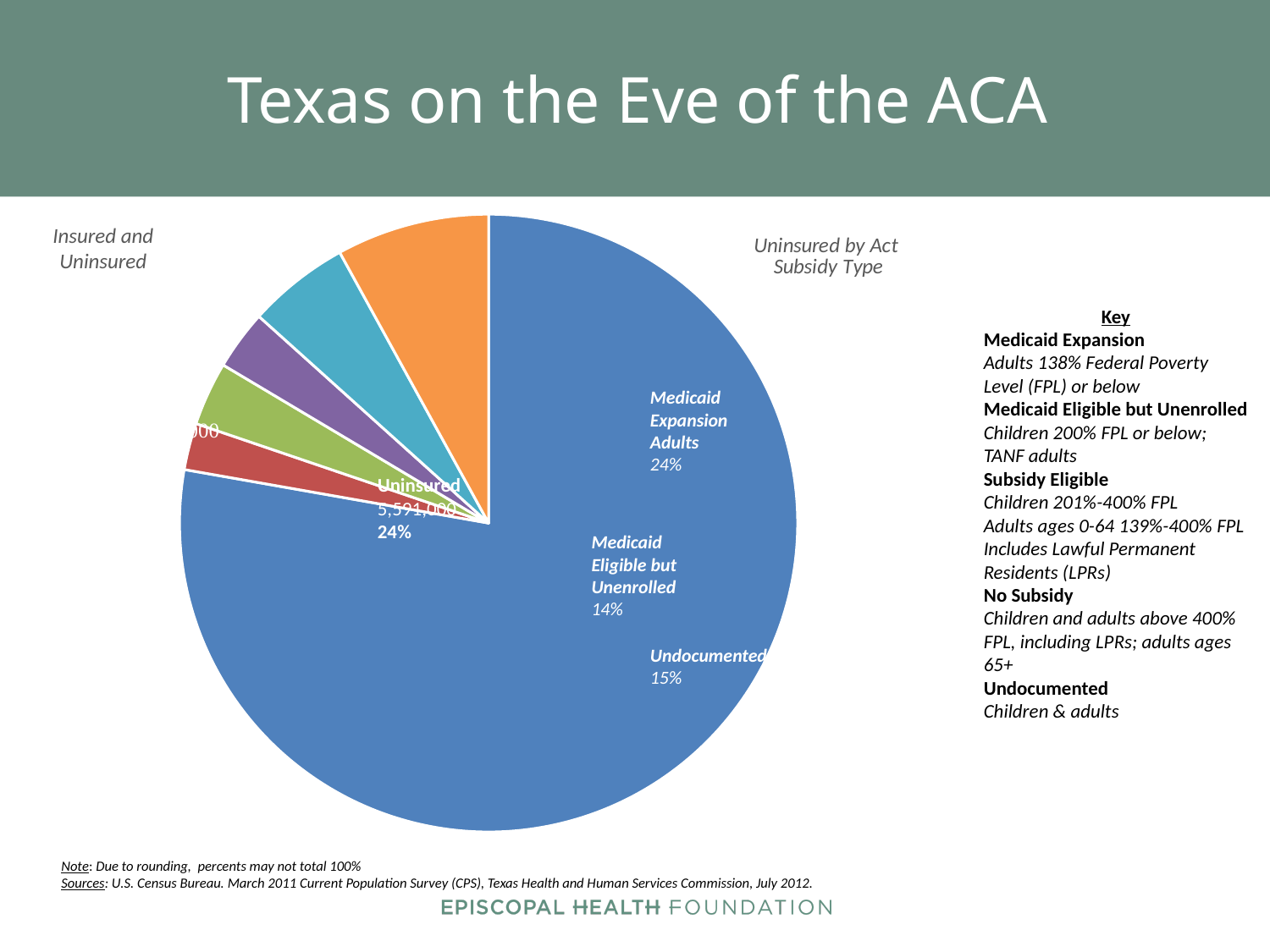
Which is larger, the share for Medicaid Expansion Adults or the share for Medicaid Eligible but Unenrolled? Medicaid Expansion Adults What percentage is shown for Medicaid Eligible but Unenrolled? 14% What kind of chart is shown on the slide? pie chart What percentage is shown for the Uninsured slice? 24% Which is larger, the share for Undocumented or the share for Medicaid Eligible but Unenrolled? Undocumented What is the difference in percentage points between Medicaid Expansion Adults (24%) and Medicaid Eligible but Unenrolled (14%)? 10 percentage points What percentage is shown for Undocumented? 15% According to the note below the chart, why might the percents not total 100%? Due to rounding What is the title of the slide containing the chart? Texas on the Eve of the ACA What percentage is shown for Medicaid Expansion Adults? 24% What number of people is shown for the Uninsured slice? 5,591,000